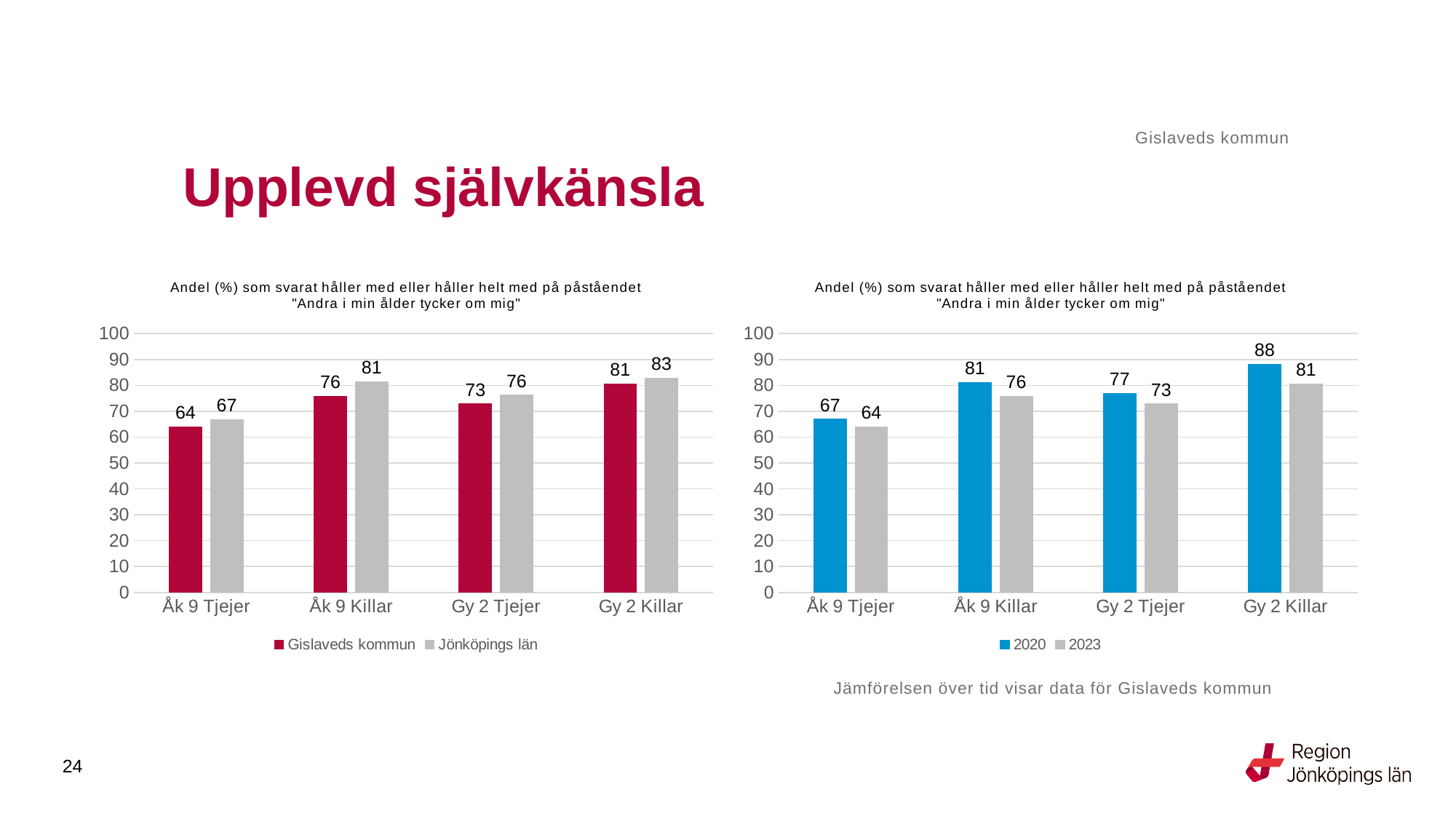
What kind of chart is the left chart? Bar chart In the right chart, which category has the highest value for 2020? Gy 2 Killar In the right chart, what is the value for 2023 for Åk 9 Tjejer? 64 How many categories are shown on the x axis of the left chart? 4 In the left chart, what is the value for Gislaveds kommun for Åk 9 Tjejer? 64 How many series does the legend of the right chart list? 2 In the right chart, which is larger for Gy 2 Tjejer: 2020 or 2023? 2020 In the right chart, what is the value for 2020 for Gy 2 Killar? 88 In the right chart, what is the difference between 2020 and 2023 for Gy 2 Killar? 7 In the left chart, what is the difference between Jönköpings län and Gislaveds kommun for Åk 9 Killar? 5 In the left chart, which category has the lowest value for Gislaveds kommun? Åk 9 Tjejer In the left chart, what is the value for Jönköpings län for Gy 2 Killar? 83